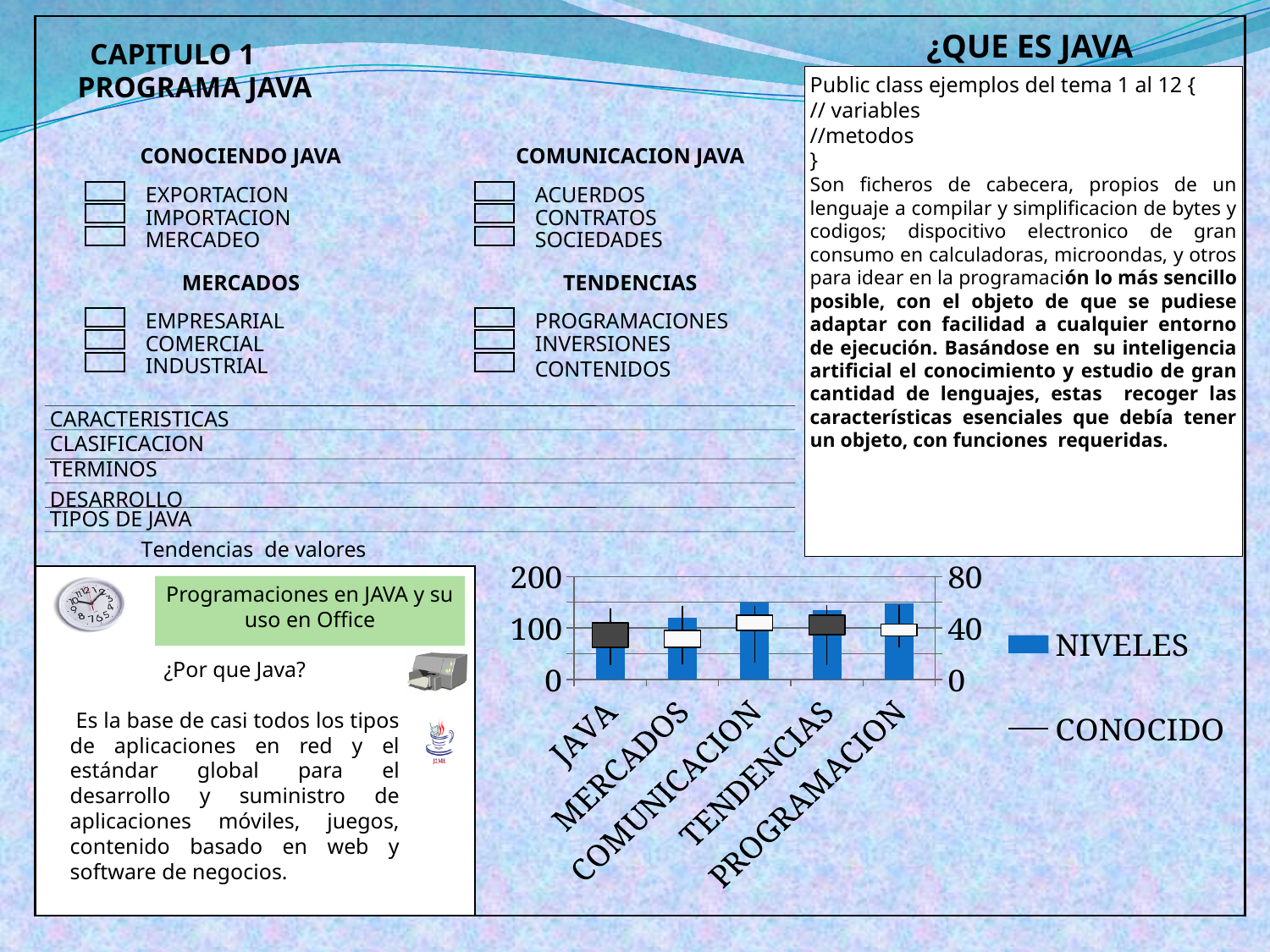
Is the NIVELES value for JAVA greater or less than 200? less What are the two series named in the chart's legend? NIVELES and CONOCIDO Which has the larger NIVELES bar, JAVA or PROGRAMACION? PROGRAMACION Is the NIVELES value for PROGRAMACION greater or less than 100? greater Is the NIVELES value for TENDENCIAS greater or less than 200? less What is the highest tick value shown on the left vertical axis of the chart? 200 What is the first category on the x axis of the chart? JAVA What colour are the NIVELES bars in the chart? Blue Which has the larger NIVELES bar, JAVA or COMUNICACION? COMUNICACION How many series does the chart's legend list? 2 How many categories are shown on the x axis of the chart? 5